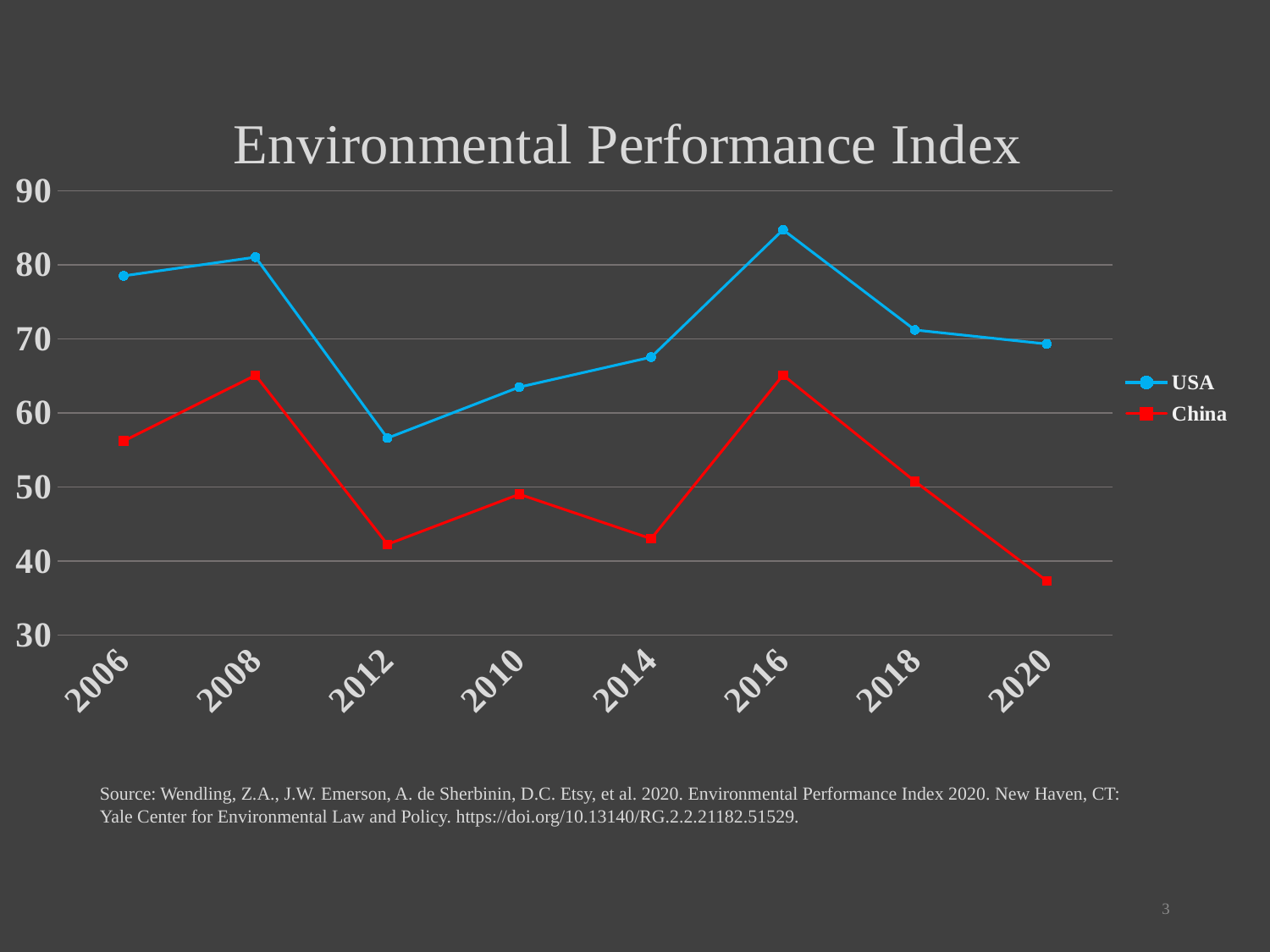
Which series has the larger value in 2018, USA or China? USA Does the China series rise or fall between 2016 and 2020? fall Is the value for China in 2020 greater or less than 40? less Is the value for USA in 2016 greater or less than 80? greater Is the value for USA in 2012 greater or less than 60? less How many series does the legend list? 2 In which year does the USA series reach its lowest value? 2012 What kind of chart is shown on the slide? line chart What is the title of the chart? Environmental Performance Index In which year does the China series reach its lowest value? 2020 How many years are plotted along the x axis? 8 In which year does the USA series reach its highest value? 2016